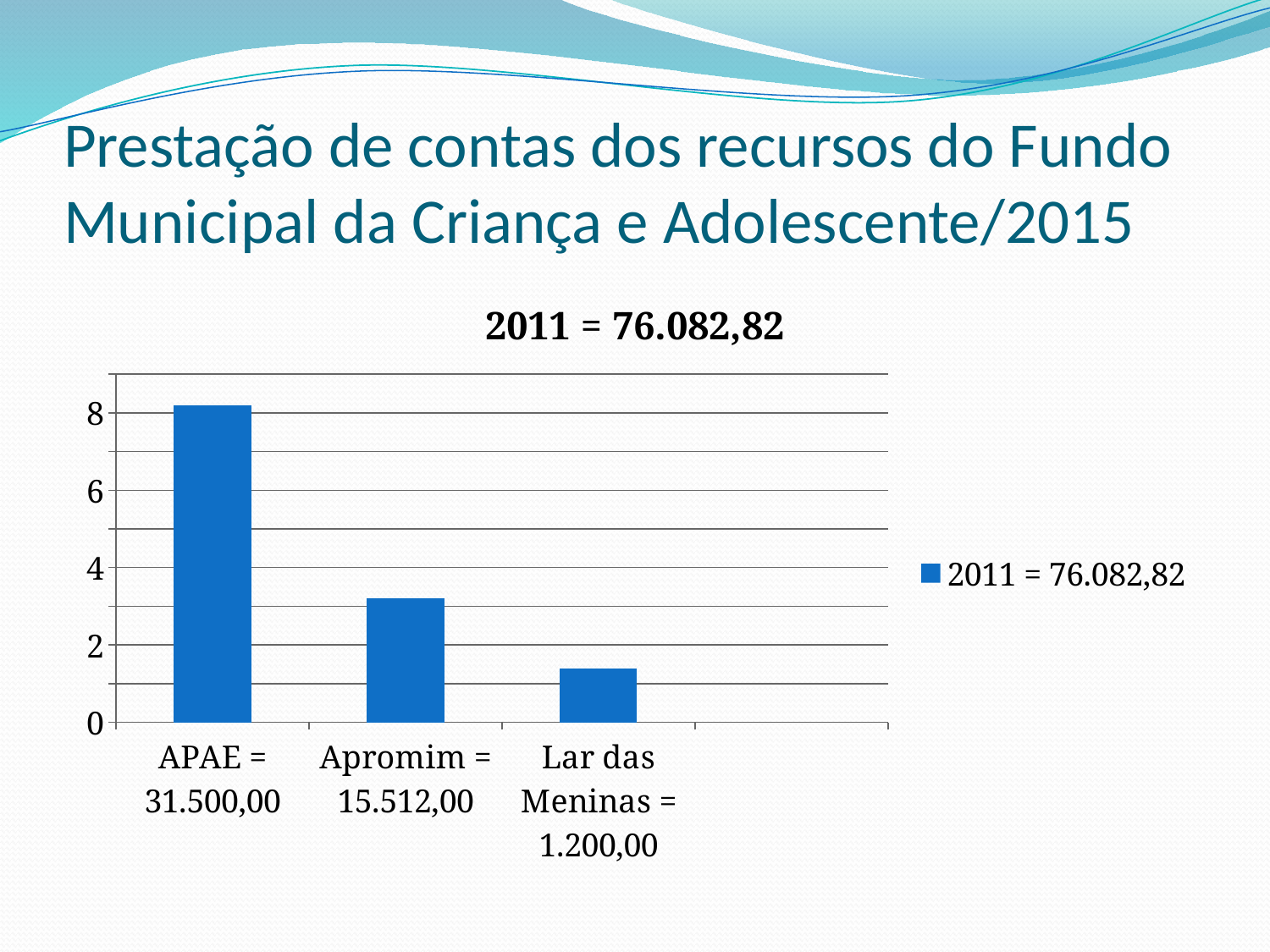
Is the bar for Apromim greater or less than 4? less Is the bar for Lar das Meninas greater or less than 2? less How many series does the legend list? 1 Is the bar for APAE greater or less than 6? greater What is the title of the chart? 2011 = 76.082,82 What type of chart is shown on the slide? bar chart Which category has the tallest bar? APAE = 31.500,00 Do the bar heights rise or fall from left to right across the categories? fall Which category has the shortest bar? Lar das Meninas = 1.200,00 How many bars (categories) does the chart show? 3 What amount is shown in the category label for Apromim? 15.512,00 Which bar is taller, Apromim or Lar das Meninas? Apromim